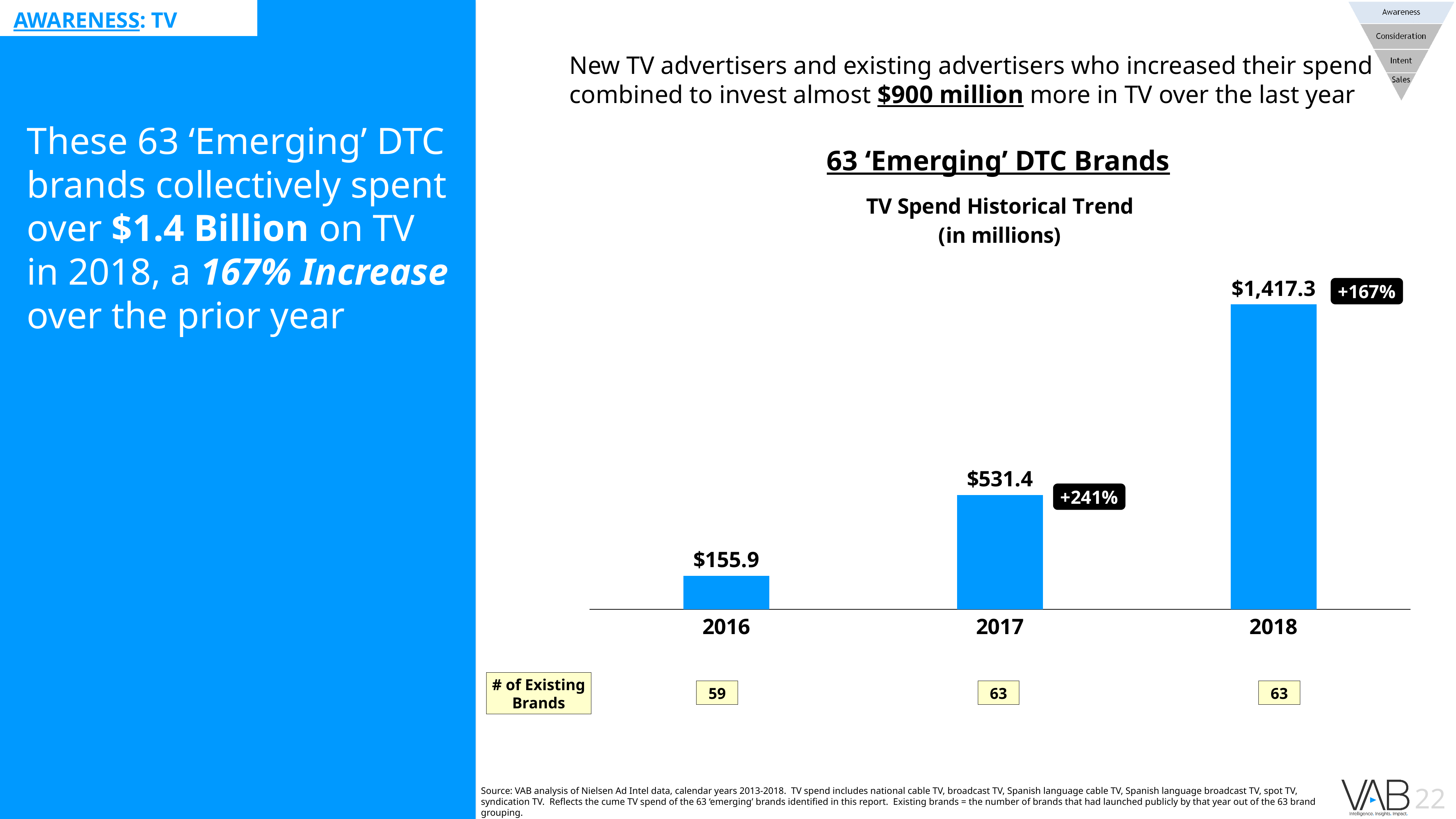
What is the difference in TV spend between 2018 and 2017? $885.9 What is the TV spend value shown for 2016? $155.9 Do TV spend values rise or fall from 2016 to 2018? Rise Which year has the highest TV spend? 2018 What percentage increase is labelled next to the 2017 bar? +241% Which year has the lowest TV spend? 2016 What is the difference in TV spend between 2017 and 2016? $375.5 How many years are shown on the chart? 3 Which year has the larger TV spend, 2016 or 2017? 2017 What is the TV spend value shown for 2018? $1,417.3 What kind of chart is used to show the TV spend historical trend? Bar chart What is the TV spend value shown for 2017? $531.4